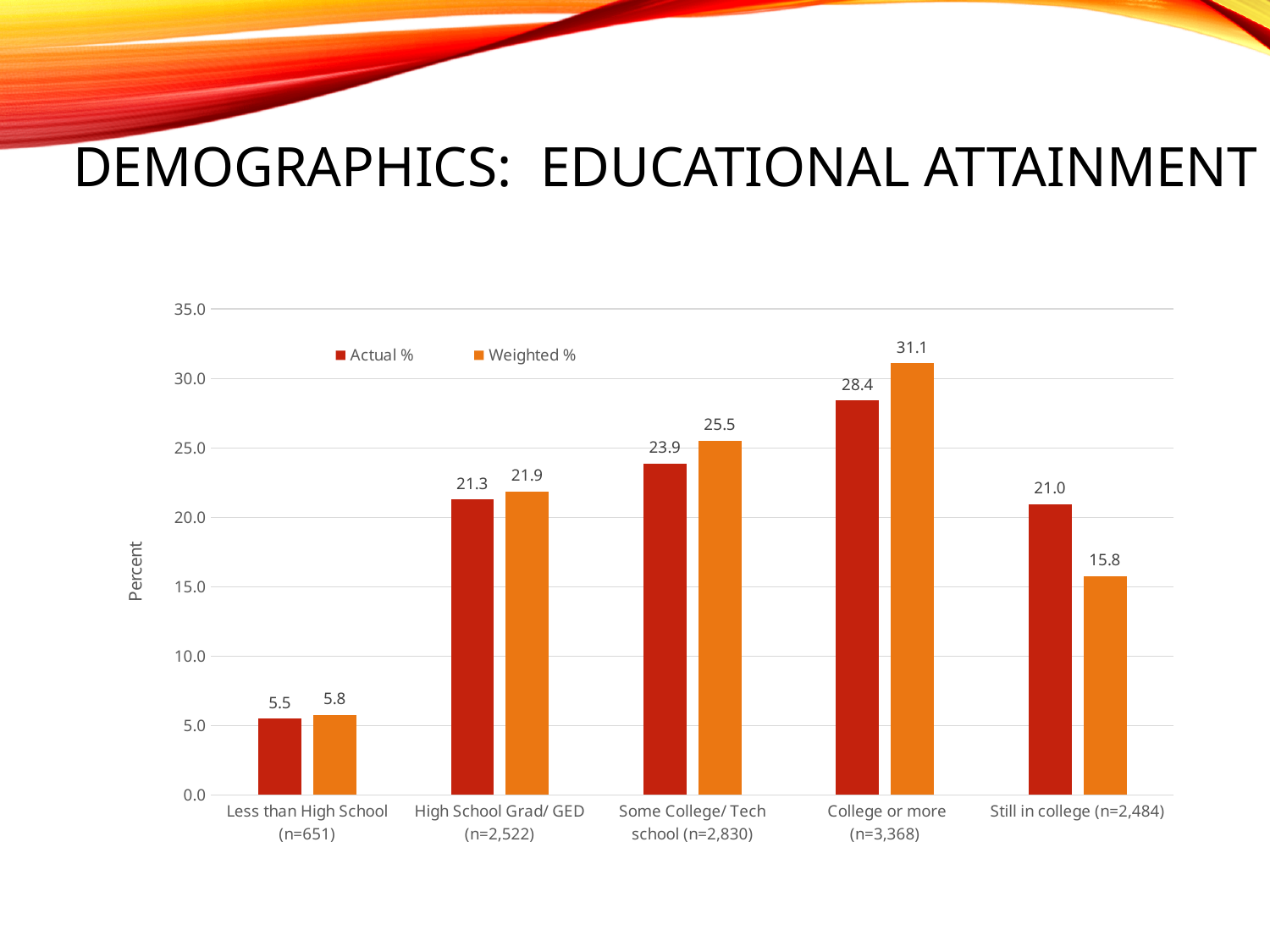
What kind of chart is shown on the slide? Bar chart Which is larger for Some College/ Tech school (n=2,830): the Actual % or the Weighted % value? Weighted % How many education categories are shown on the x axis? 5 What is the Weighted % value for Still in college (n=2,484)? 15.8 Which category has the lowest Actual % value? Less than High School (n=651) What is the difference between the Weighted % and Actual % values for College or more (n=3,368)? 2.7 What is the Weighted % value for Less than High School (n=651)? 5.8 What is the difference between the Actual % and Weighted % values for Still in college (n=2,484)? 5.2 Is the Weighted % value for College or more (n=3,368) greater or less than 30.0? greater Which category has the highest Weighted % value? College or more (n=3,368) How many series does the legend list? 2 What is the Actual % value for College or more (n=3,368)? 28.4